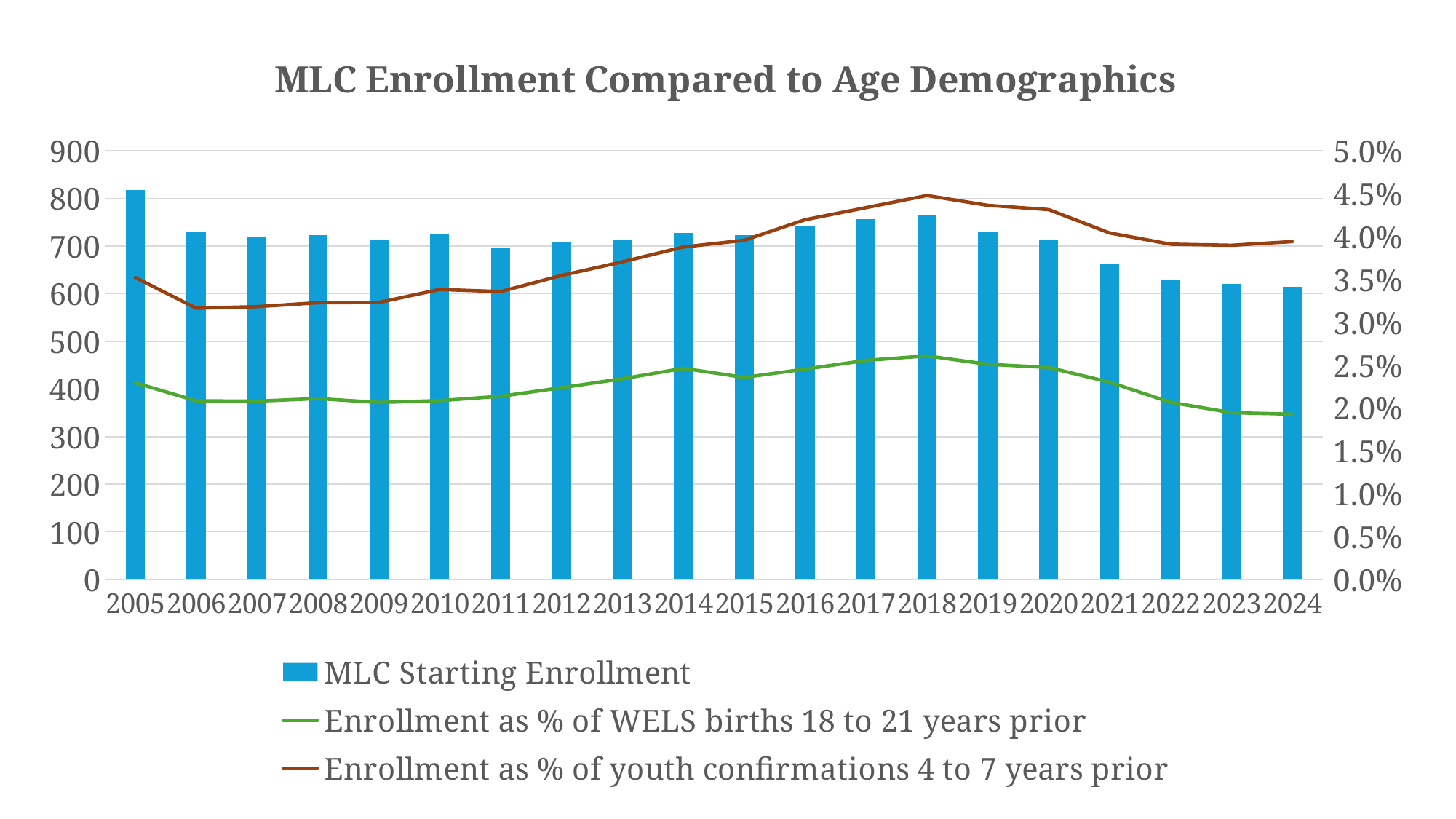
Is the MLC Starting Enrollment for 2005 greater or less than 800? greater Is the MLC Starting Enrollment for 2021 greater or less than 700? less How many series does the legend list? 3 Which year has the larger MLC Starting Enrollment, 2005 or 2024? 2005 Is the 'Enrollment as % of youth confirmations 4 to 7 years prior' value for 2018 greater or less than 4.0%? greater In which year does the 'Enrollment as % of youth confirmations 4 to 7 years prior' line reach its highest point? 2018 How many years are shown on the x axis? 20 What kind of chart is this? Combined bar and line chart Which year has the highest MLC Starting Enrollment bar? 2005 Do the MLC Starting Enrollment bars rise or fall from 2018 to 2024? fall What is the title of the chart? MLC Enrollment Compared to Age Demographics